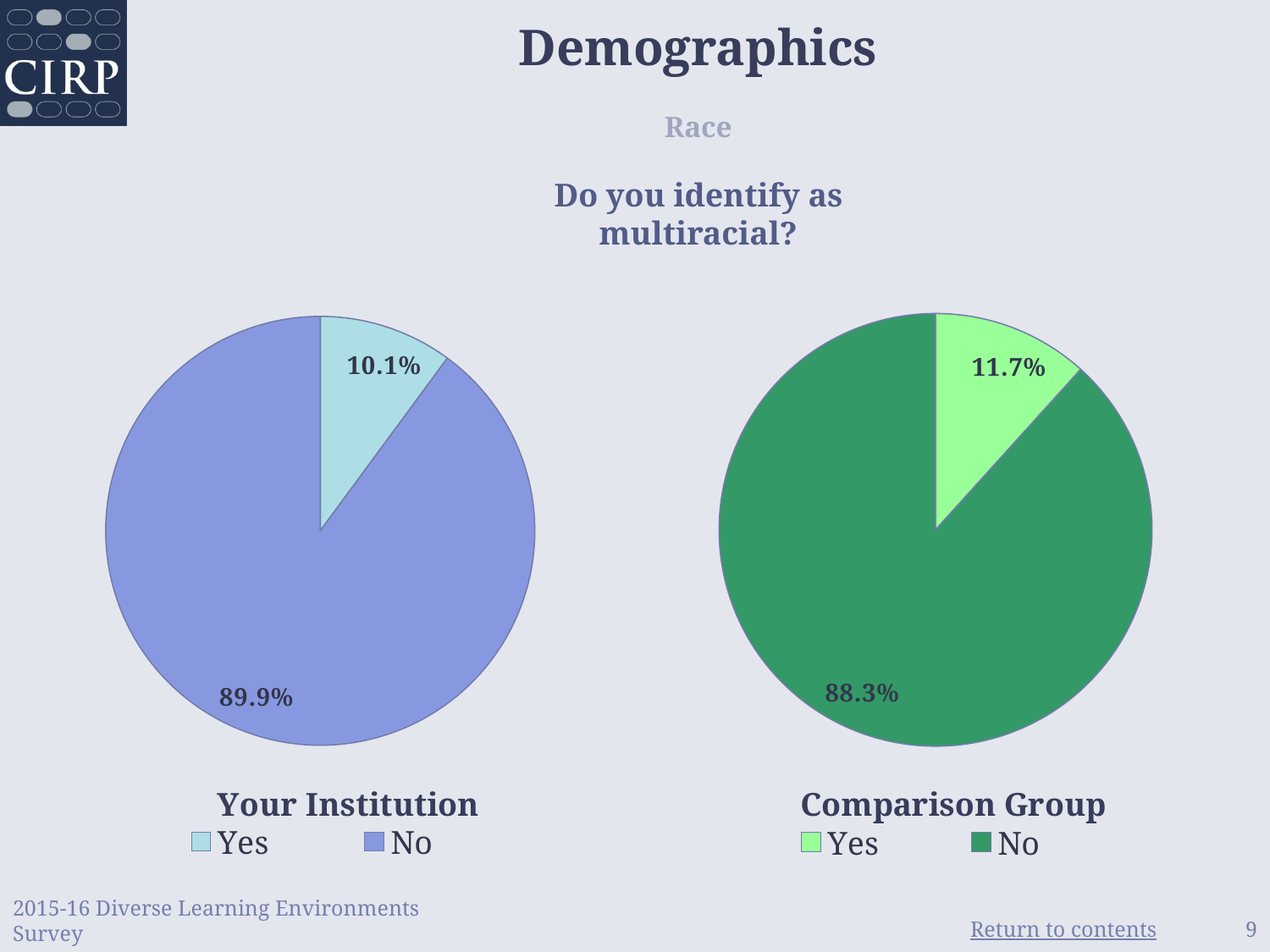
In the Comparison Group chart, what percentage of respondents answered Yes? 11.7% In the Your Institution chart, which category has the largest slice? No What type of chart is the Your Institution chart? Pie chart In the Comparison Group chart, which category has the smallest slice? Yes Which is larger: the Yes share in the Your Institution chart or the Yes share in the Comparison Group chart? Comparison Group In the Comparison Group chart, what percentage of respondents answered No? 88.3% What are the legend entries for the Your Institution chart? Yes, No What colour is the No slice in the Comparison Group chart? Dark green In the Your Institution chart, what percentage of respondents answered No? 89.9% In the Your Institution chart, what is the difference between the No and Yes percentages? 79.8% In the Your Institution chart, what percentage of respondents answered Yes? 10.1% How many categories does the Comparison Group chart show? 2